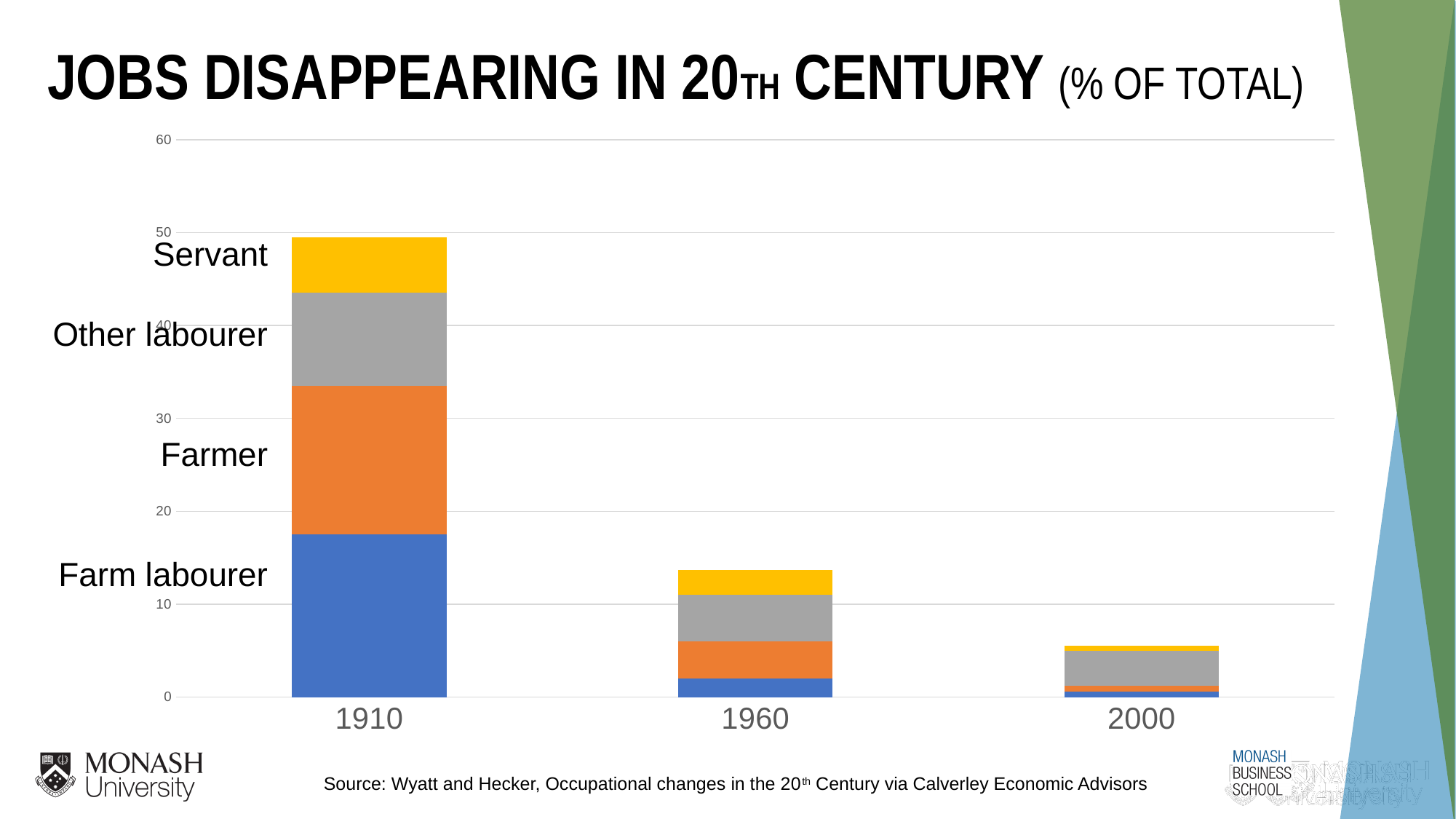
What colour represents the Farm labourer series? Blue How many job categories (series) are stacked in each bar? 4 Which year has the highest total bar? 1910 Do the total bar heights rise or fall from 1910 to 2000? Fall What kind of chart is shown on the slide? Stacked bar chart Is the total bar for 1960 greater or less than 20? less Is the total bar for 2000 greater or less than 10? less Which year has the lowest total bar? 2000 In 1910, which segment is larger: Farmer or Servant? Farmer Is the total bar for 1910 greater or less than 40? greater How many years are shown on the x axis of the chart? 3